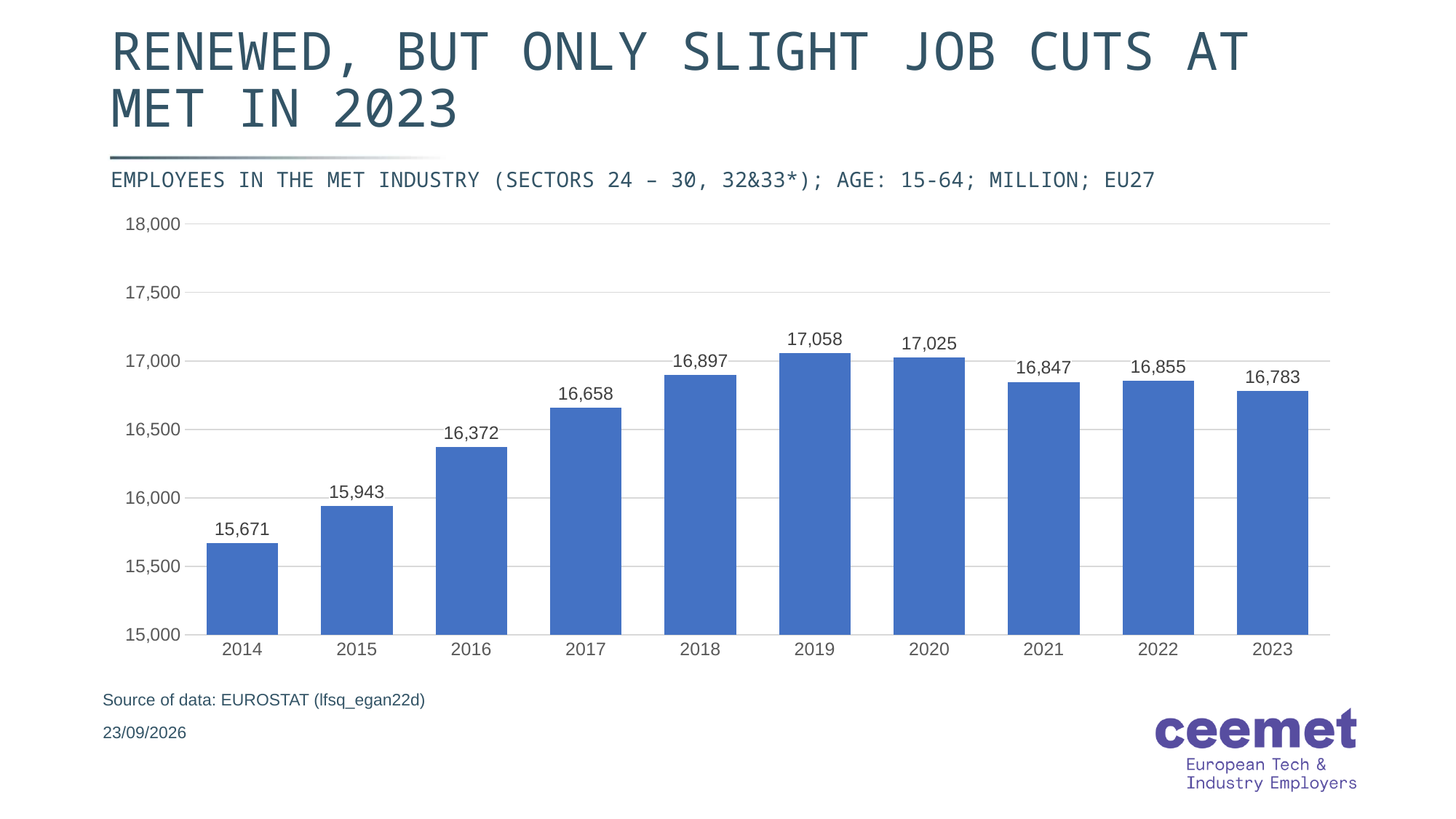
Do the values rise or fall from 2014 to 2019? rise What is the value for 2014? 15,671 Is the value for 2017 greater or less than 16,500? greater How many years are shown on the x axis? 10 What is the source of the data given below the chart? EUROSTAT (lfsq_egan22d) Which year has the highest value? 2019 What is the difference between the values for 2022 and 2023? 72 Which year has the lowest value? 2014 What is the value for 2023? 16,783 What kind of chart is shown on the slide? bar chart What is the value for 2019? 17,058 Which is larger, the value for 2020 or the value for 2021? 2020